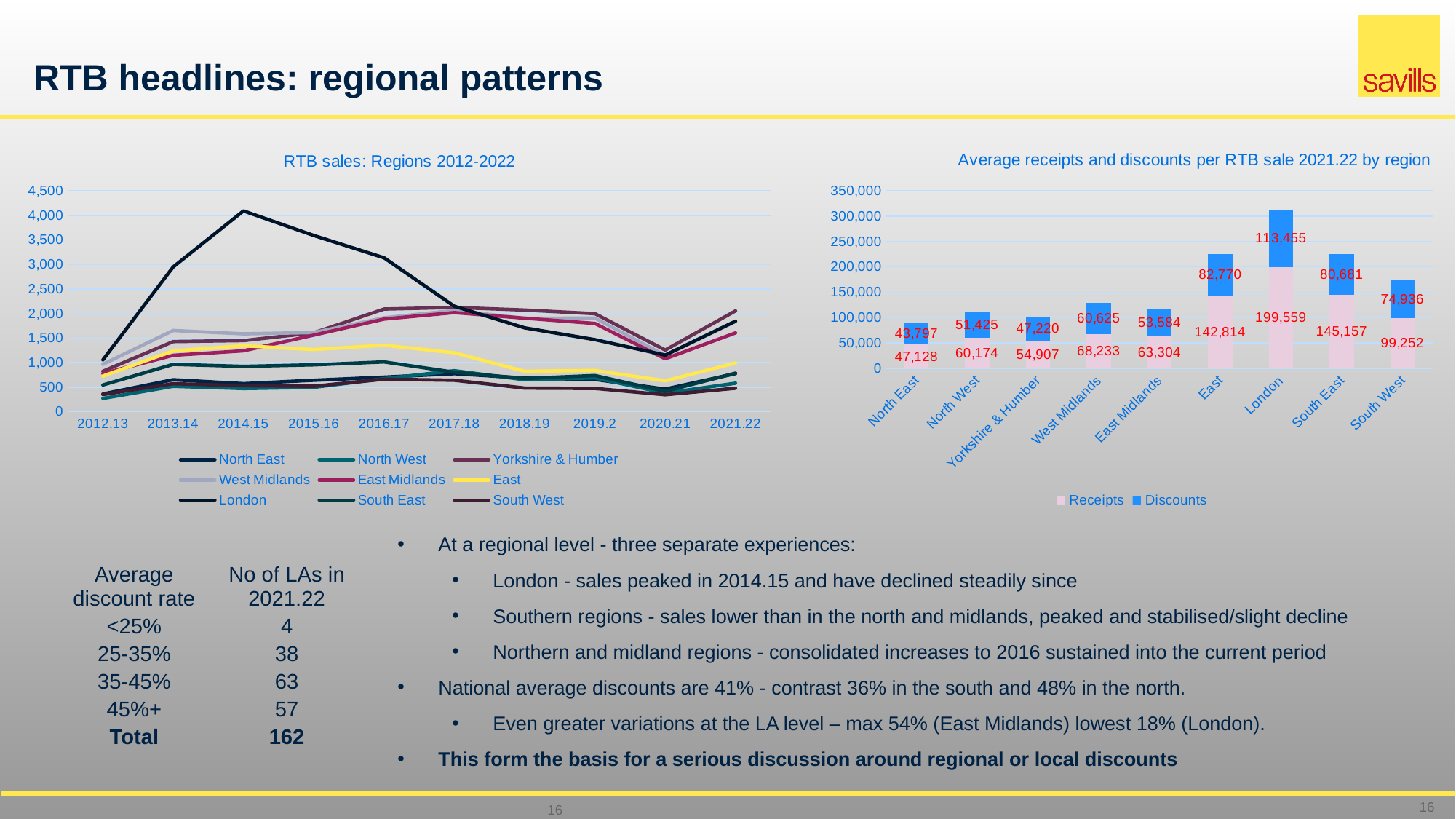
In the 'Average receipts and discounts per RTB sale 2021.22 by region' chart, which region has the highest Receipts value? London In the 'Average receipts and discounts per RTB sale 2021.22 by region' chart, how many regions are shown on the x axis? 9 What kind of chart is 'RTB sales: Regions 2012-2022'? line chart In the 'Average receipts and discounts per RTB sale 2021.22 by region' chart, what is the Discounts value for West Midlands? 60,625 In the 'RTB sales: Regions 2012-2022' chart, is the value for London in 2014.15 greater or less than 3,500? greater In the 'Average receipts and discounts per RTB sale 2021.22 by region' chart, how many series does the legend list? 2 In the 'Average receipts and discounts per RTB sale 2021.22 by region' chart, what is the Receipts value for London? 199,559 In the 'Average receipts and discounts per RTB sale 2021.22 by region' chart, what is the difference between the Receipts values for London and South East? 54,402 In the 'Average receipts and discounts per RTB sale 2021.22 by region' chart, which region has the lowest Discounts value? North East In the 'Average receipts and discounts per RTB sale 2021.22 by region' chart, what is the total of the stacked bar for North East? 90,925 In the 'RTB sales: Regions 2012-2022' chart, how many series does the legend list? 9 What kind of chart is 'Average receipts and discounts per RTB sale 2021.22 by region'? bar chart